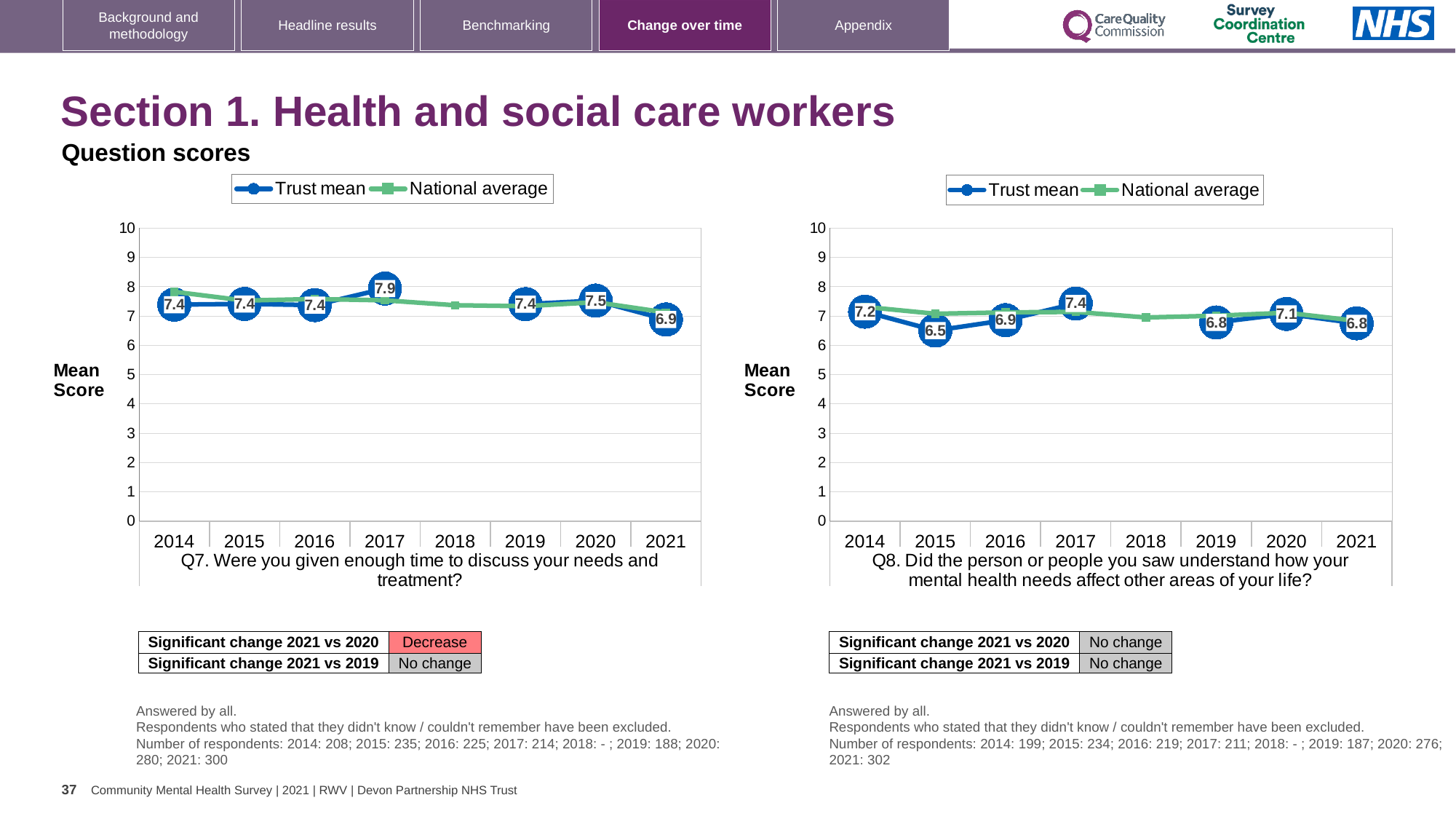
In the Q7 chart, what is the difference between the Trust mean in 2020 and in 2021? 0.6 In the Q8 chart, what is the Trust mean for 2015? 6.5 In the Q8 chart, is the National average for 2014 greater or less than 5? greater In the Q8 chart, which year has the highest Trust mean? 2017 In the Q7 chart, which year has the lowest Trust mean? 2021 How many series does the legend of the Q7 chart list? 2 In the Q8 chart, which year has the lowest Trust mean? 2015 In the Q8 chart, is the Trust mean for 2017 larger or smaller than the Trust mean for 2020? larger What kind of chart is the Q8 chart? line chart In the Q7 chart, which year has the highest Trust mean? 2017 In the Q7 chart, what is the Trust mean for 2017? 7.9 In the Q7 chart, what is the Trust mean for 2021? 6.9